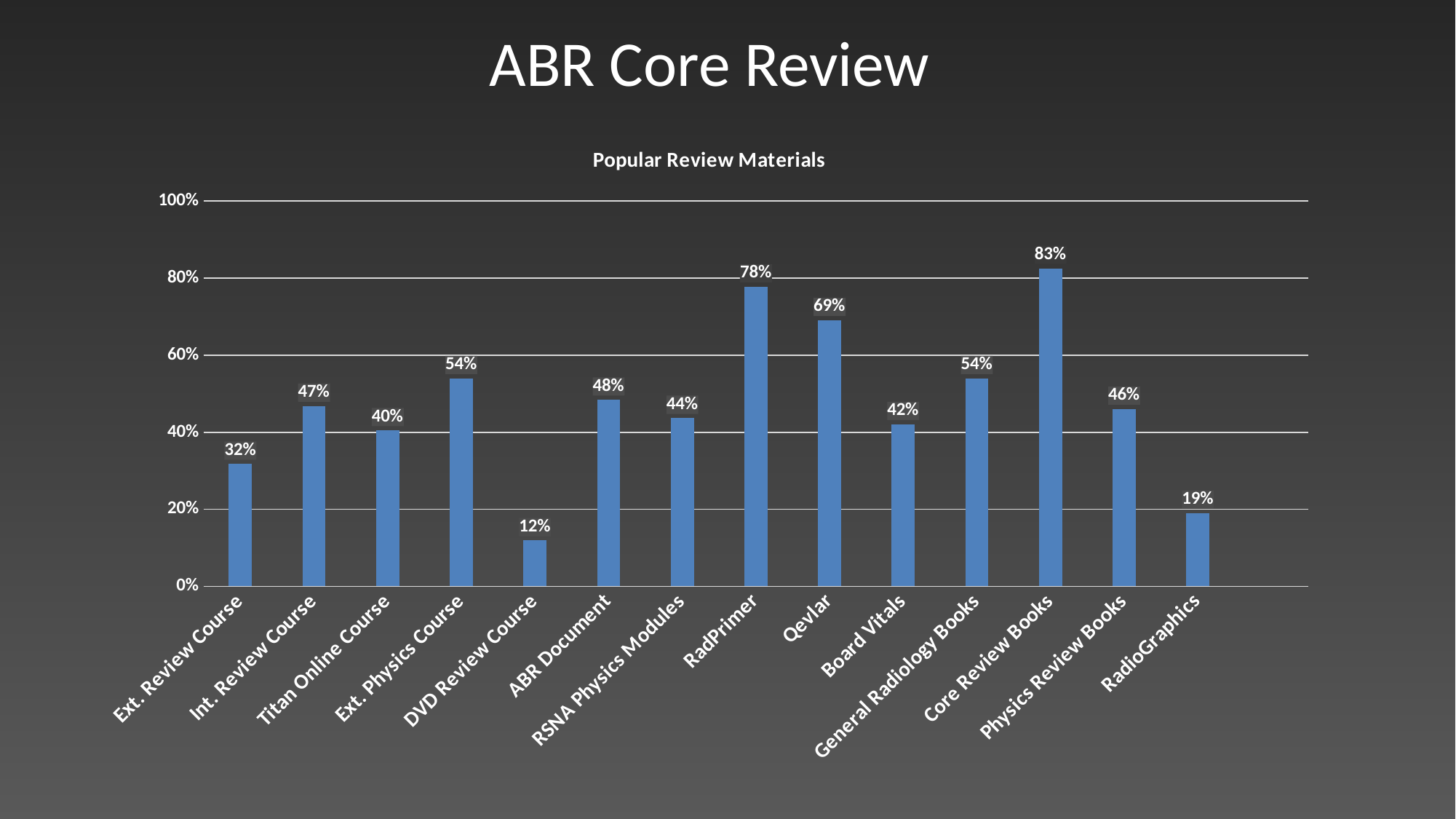
What is the title of the chart? Popular Review Materials What is the difference between Core Review Books and RadPrimer? 5% What is the difference between Ext. Physics Course and Ext. Review Course? 22% Is the value for Board Vitals greater or less than 40%? greater What is the value for DVD Review Course? 12% How many categories are shown on the x axis? 14 Which category has the lowest value? DVD Review Course What is the value for Qevlar? 69% What is the value for RadPrimer? 78% What kind of chart is this? bar chart Which is larger, Int. Review Course or Titan Online Course? Int. Review Course Which category has the highest value? Core Review Books